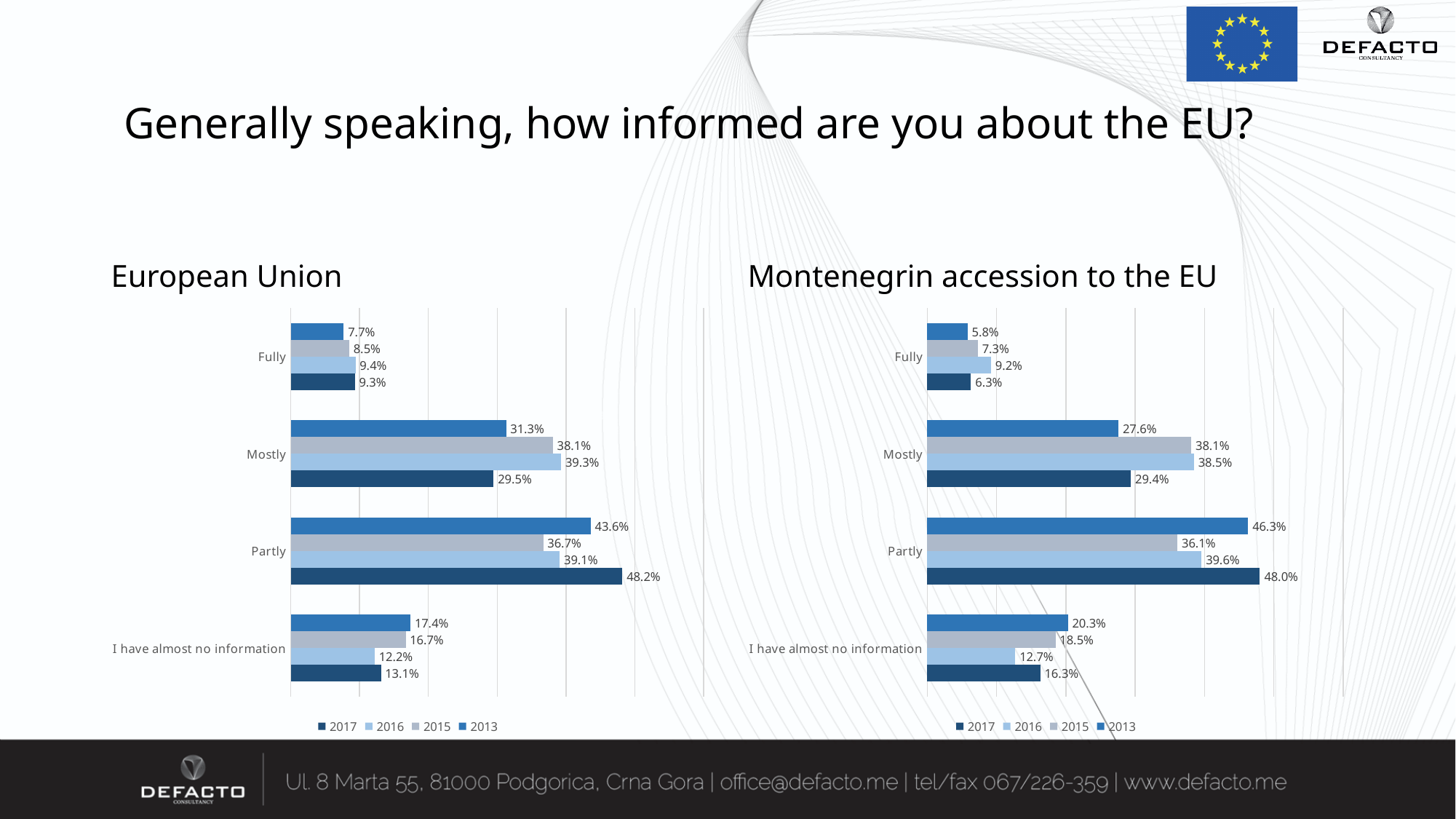
In the Montenegrin accession to the EU chart, what is the 2016 value for 'Fully'? 9.2% In the Montenegrin accession to the EU chart, which category has the highest 2017 value? Partly What are the titles of the two charts on the slide? European Union; Montenegrin accession to the EU What type of chart is the European Union chart? Bar chart In the Montenegrin accession to the EU chart, which is larger for 'Mostly': the 2016 value or the 2017 value? 2016 In the European Union chart, what is the 2016 value for 'Mostly'? 39.3% In the European Union chart, what is the difference between the 2017 and 2013 values for 'Partly'? 4.6% How many categories are shown on the y axis of the Montenegrin accession to the EU chart? 4 In the Montenegrin accession to the EU chart, what is the 2013 value for 'I have almost no information'? 20.3% In the European Union chart, what percentage of respondents said they were 'Partly' informed in 2017? 48.2% In the European Union chart, which category has the lowest 2013 value? Fully How many series does the legend of the European Union chart list? 4